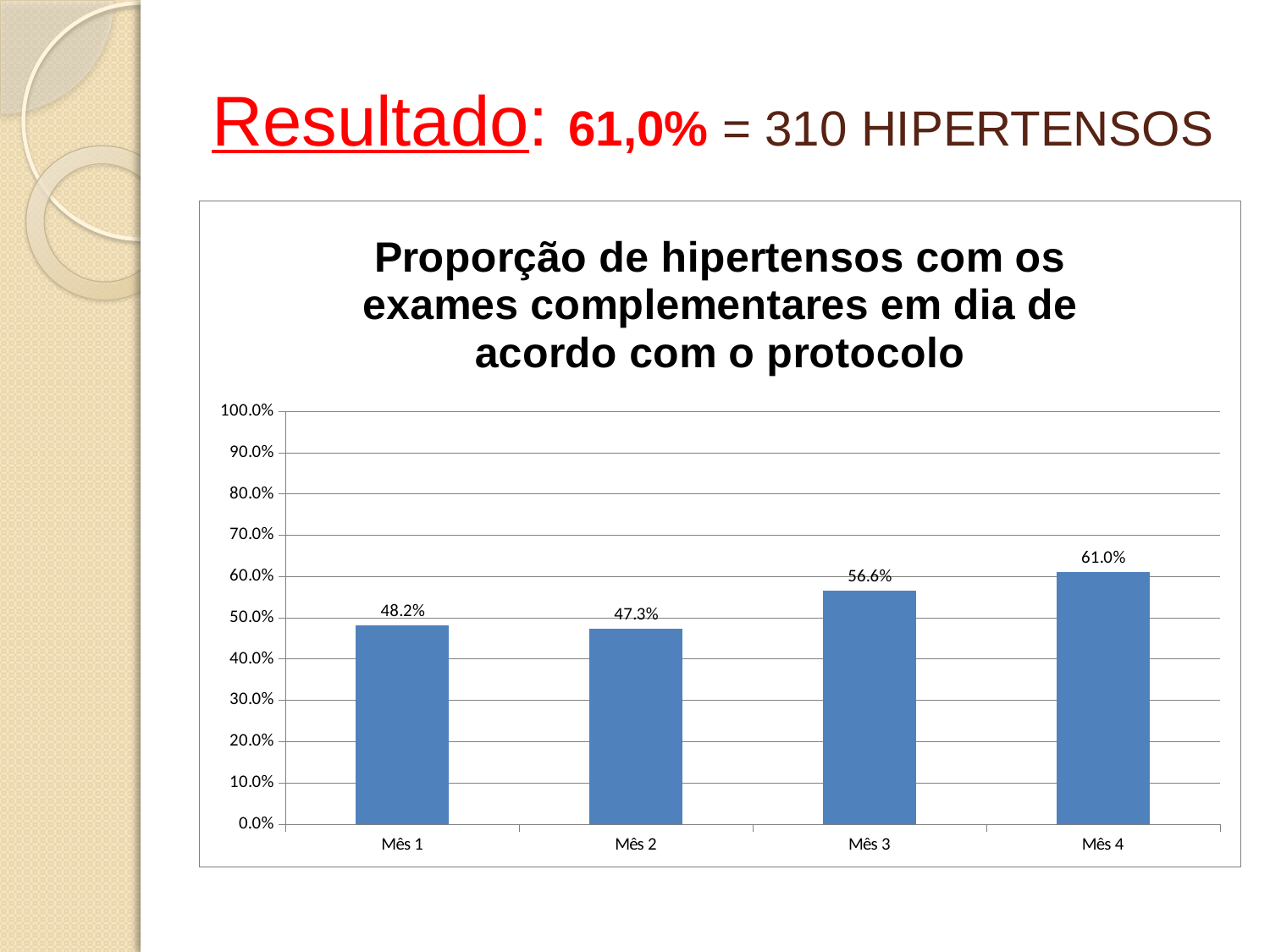
What is the value for Mês 4? 61.0% What is the title of the chart? Proporção de hipertensos com os exames complementares em dia de acordo com o protocolo What is the value for Mês 2? 47.3% How many months are shown on the x axis? 4 Is the value for Mês 4 greater or less than 50.0%? greater Which month has the lowest value? Mês 2 What kind of chart is shown on the slide? bar chart Which month has the highest value? Mês 4 Which is larger, the value for Mês 3 or the value for Mês 2? Mês 3 What is the value for Mês 3? 56.6% What is the value for Mês 1? 48.2% What is the difference between the values for Mês 4 and Mês 1? 12.8%